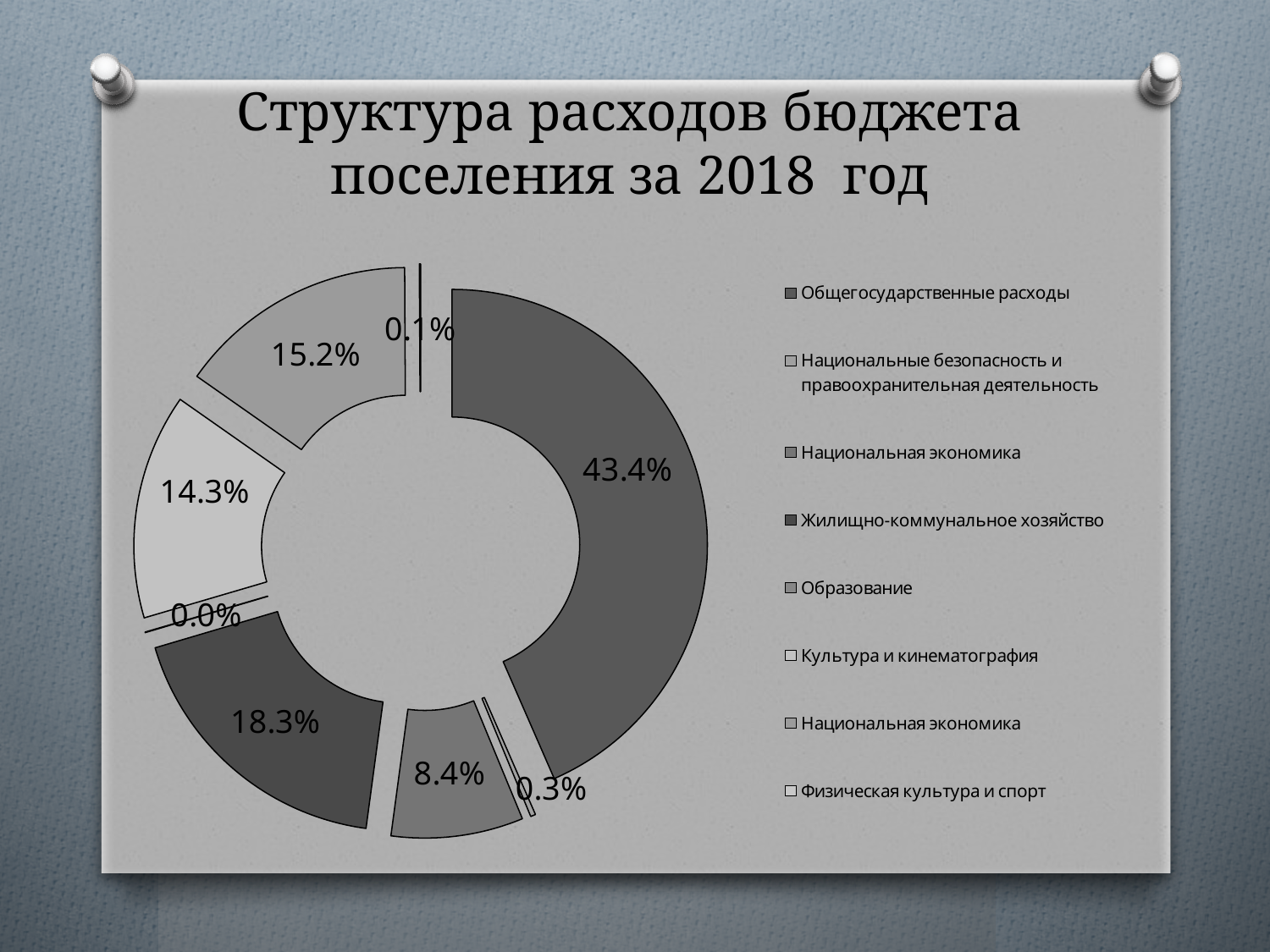
What share of expenditures is Жилищно-коммунальное хозяйство? 18.3% What share of expenditures is Физическая культура и спорт? 0.1% How many slices does the doughnut chart have? 8 What kind of chart is shown on the slide? doughnut (pie) chart Which has the larger share: Жилищно-коммунальное хозяйство or Культура и кинематография? Жилищно-коммунальное хозяйство What is the title of the chart on the slide? Структура расходов бюджета поселения за 2018 год What share of expenditures is Культура и кинематография? 14.3% How many entries does the legend list? 8 What is the largest share shown on the chart? 43.4% What share of expenditures is Общегосударственные расходы? 43.4% What is the difference between the shares of Общегосударственные расходы and Жилищно-коммунальное хозяйство? 25.1% What is the smallest share shown on the chart? 0.0%